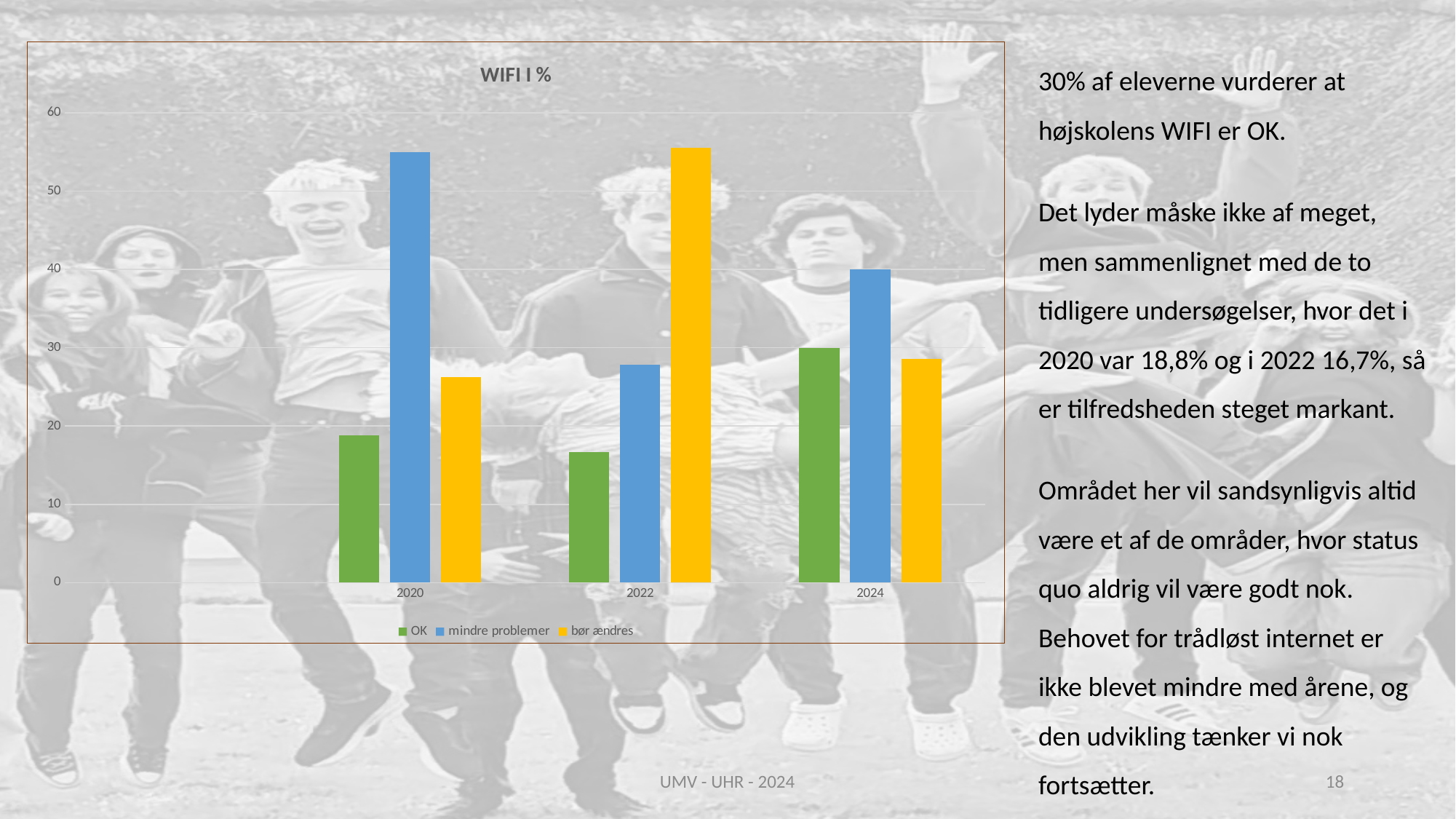
Which series has the highest bar for 2020? mindre problemer Is the value for 'mindre problemer' in 2020 greater or less than 50? greater How many series does the chart legend list? 3 How many years (categories) are shown on the x axis of the chart? 3 What kind of chart is shown on the slide? bar chart Which series has the highest bar for 2022? bør ændres Which is larger: the 'bør ændres' value in 2022 or in 2024? 2022 What is the title of the chart? WIFI I % Which series has the lowest bar for 2022? OK Is the value for 'bør ændres' in 2024 greater or less than 30? less Is the value for 'OK' in 2022 greater or less than 20? less Does the 'OK' value rise or fall from 2022 to 2024? rise